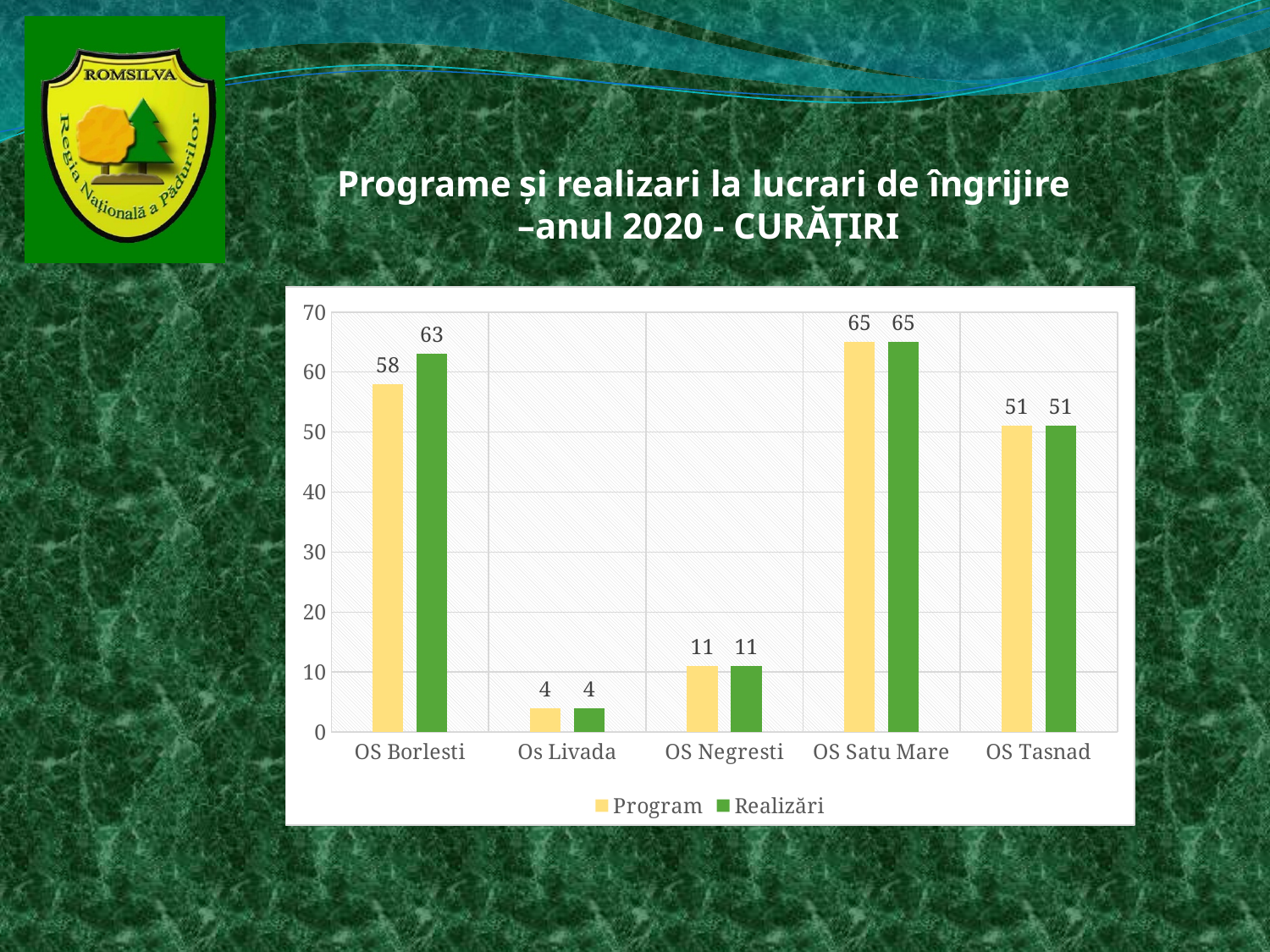
What is the difference between the Realizări and Program values for OS Borlesti? 5 How many categories are shown on the x axis? 5 How many series does the legend list? 2 Which category has the highest Program value? OS Satu Mare Which is larger for OS Borlesti, the Program value or the Realizări value? Realizări Which series is shown in green in the legend? Realizări What is the Program value for Os Livada? 4 What kind of chart is shown on the slide? Bar chart What is the Realizări value for OS Borlesti? 63 What is the Realizări value for OS Negresti? 11 Which category has the lowest Realizări value? Os Livada What is the Program value for OS Borlesti? 58